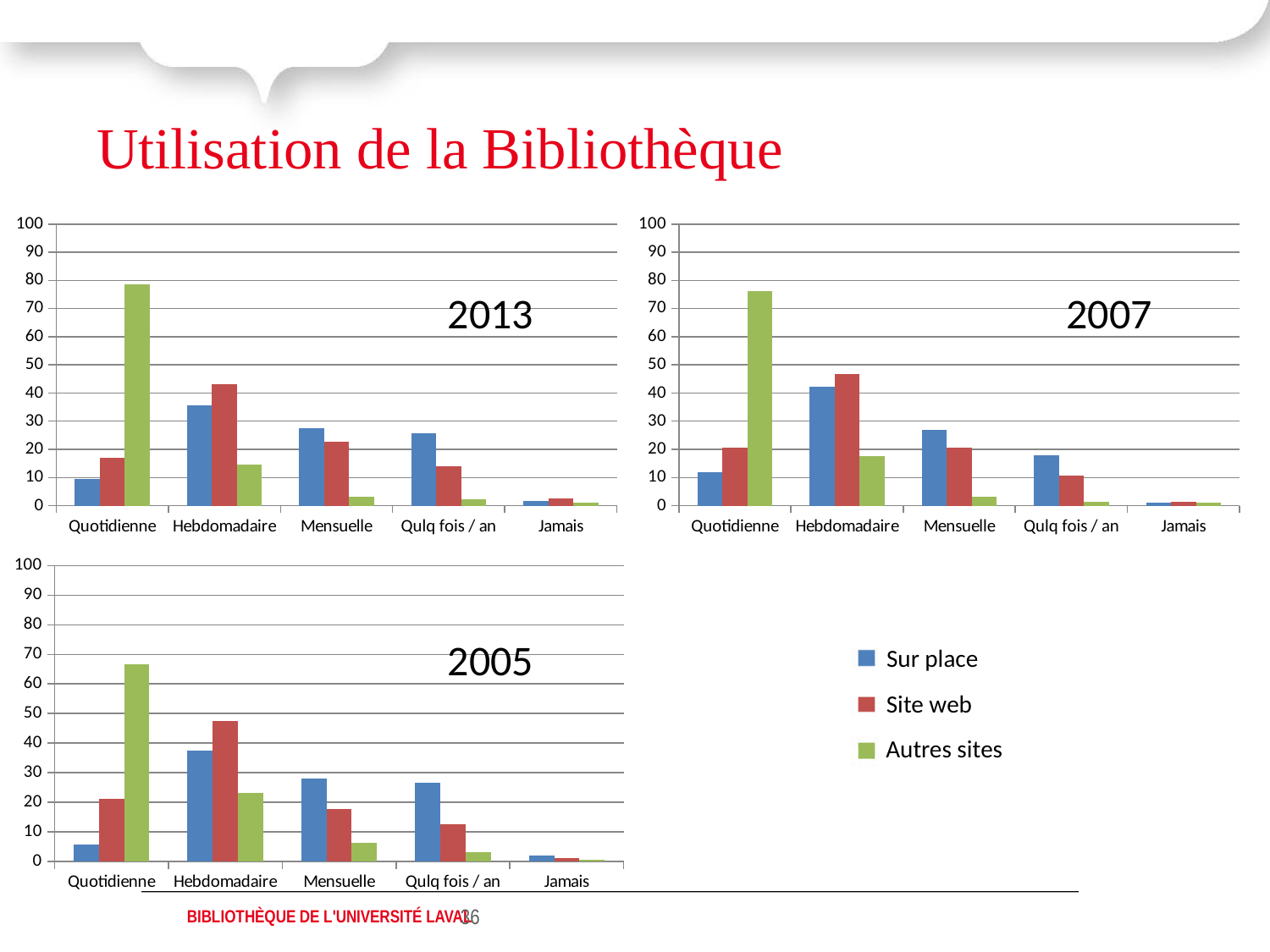
In the 2013 chart, for Quotidienne, which is larger: Sur place or Site web? Site web In the 2007 chart, which category has the highest Sur place bar? Hebdomadaire In the 2005 chart, how many categories are shown on the x axis? 5 In the 2013 chart, which category has the lowest Sur place bar? Jamais In the 2005 chart, for Hebdomadaire, which is larger: Sur place or Site web? Site web In the 2013 chart, is the Autres sites value for Quotidienne greater or less than 70? greater How many series does the legend list for the charts? 3 In the 2013 chart, which category has the highest Autres sites bar? Quotidienne What are the three series named in the legend? Sur place, Site web, Autres sites In the 2007 chart, is the Sur place value for Hebdomadaire greater or less than 30? greater What kind of chart is the 2013 chart? bar chart In the 2005 chart, is the Autres sites value for Quotidienne greater or less than 60? greater